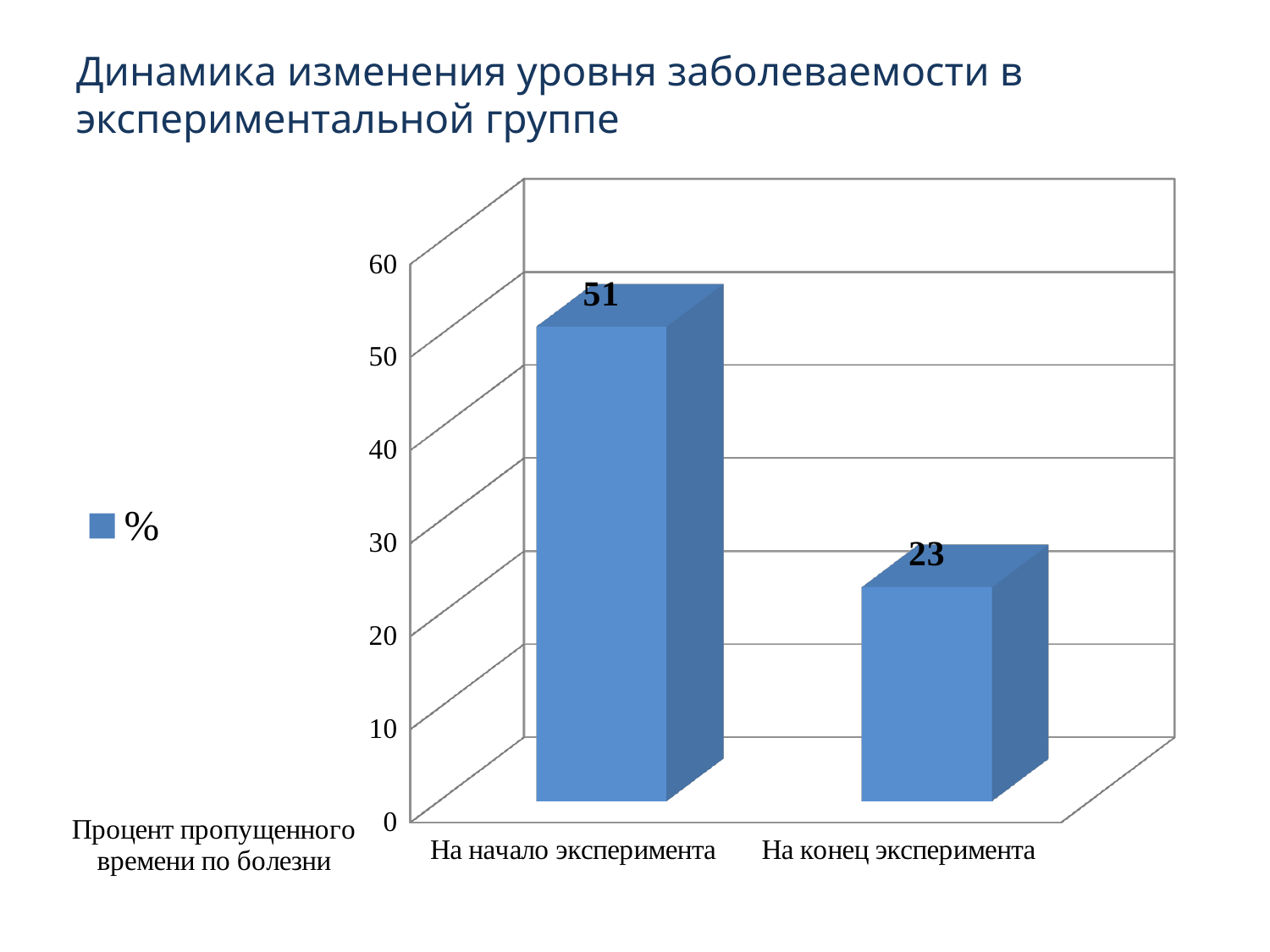
Which category has the highest value? На начало эксперимента What is the value for "На начало эксперимента"? 51 How many series does the legend list? 1 Which is larger: the value for "На начало эксперимента" or for "На конец эксперимента"? На начало эксперимента Is the value for "На начало эксперимента" greater or less than 40? greater What is the value for "На конец эксперимента"? 23 How many categories are shown on the x axis? 2 Do the values rise or fall from the start to the end of the experiment? fall What is the difference between the values for "На начало эксперимента" and "На конец эксперимента"? 28 Is the value for "На конец эксперимента" greater or less than 30? less Which category has the lowest value? На конец эксперимента What kind of chart is shown on the slide? bar chart